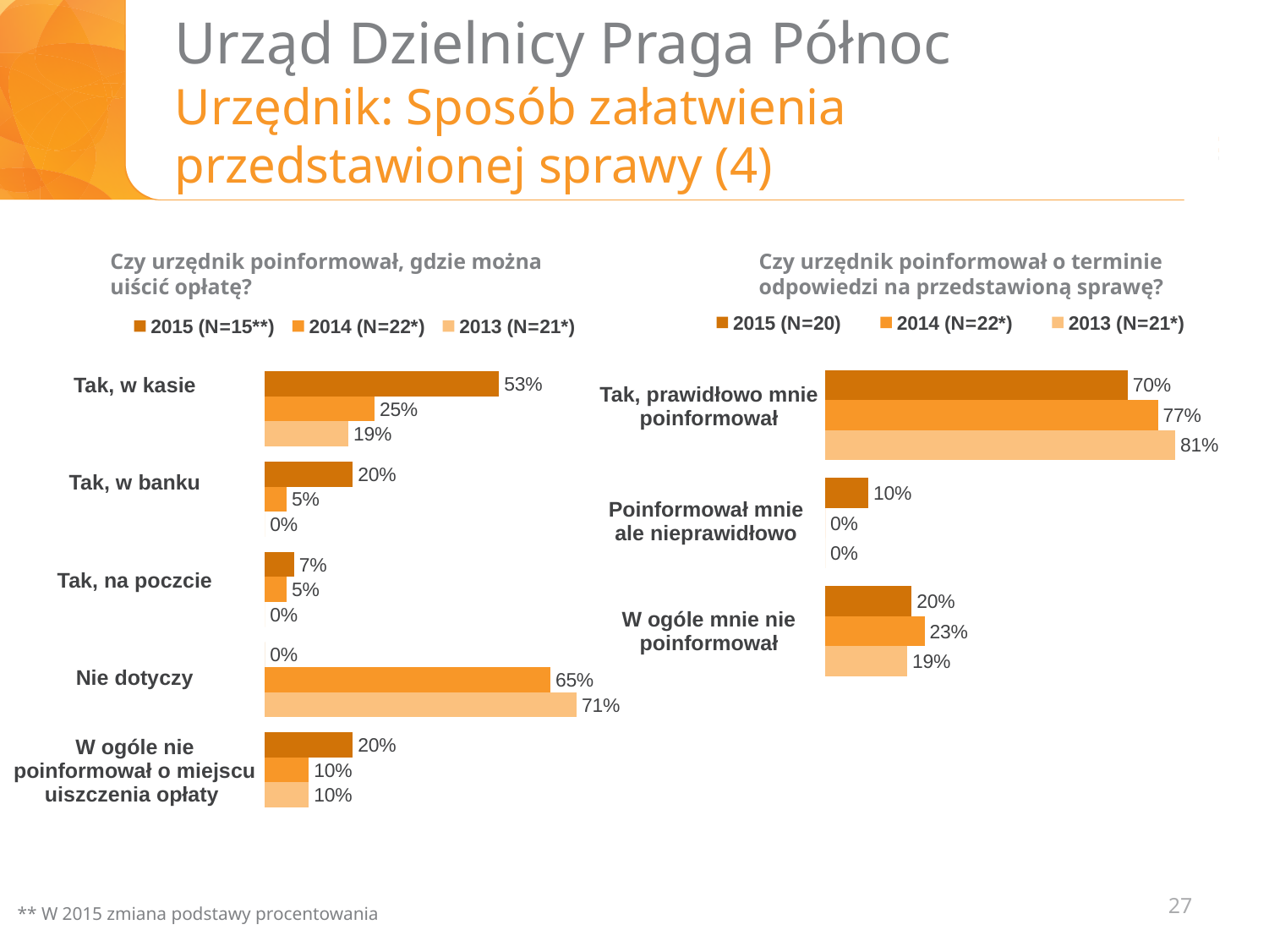
In the right chart ('Czy urzędnik poinformował o terminie odpowiedzi na przedstawioną sprawę?'), what is the value for 'Tak, prawidłowo mnie poinformował' in 2014 (N=22*)? 77% In the left chart ('Czy urzędnik poinformował, gdzie można uiścić opłatę?'), what is the value for 'Tak, w kasie' in 2015 (N=15**)? 53% What type of chart is the right chart ('Czy urzędnik poinformował o terminie odpowiedzi na przedstawioną sprawę?')? Bar chart In the right chart ('Czy urzędnik poinformował o terminie odpowiedzi na przedstawioną sprawę?'), what is the difference between the 2013 (N=21*) and 2015 (N=20) values for 'Tak, prawidłowo mnie poinformował'? 11 percentage points In the right chart ('Czy urzędnik poinformował o terminie odpowiedzi na przedstawioną sprawę?'), which category has the highest value for 2013 (N=21*)? Tak, prawidłowo mnie poinformował In the left chart ('Czy urzędnik poinformował, gdzie można uiścić opłatę?'), which is larger for 'Tak, w kasie': the 2014 (N=22*) value or the 2013 (N=21*) value? 2014 (N=22*) How many series does the legend of the right chart ('Czy urzędnik poinformował o terminie odpowiedzi na przedstawioną sprawę?') list? 3 What is the first legend entry of the left chart ('Czy urzędnik poinformował, gdzie można uiścić opłatę?')? 2015 (N=15**) How many categories are shown in the left chart ('Czy urzędnik poinformował, gdzie można uiścić opłatę?')? 5 In the left chart ('Czy urzędnik poinformował, gdzie można uiścić opłatę?'), which category has the lowest value for 2015 (N=15**)? Nie dotyczy In the left chart ('Czy urzędnik poinformował, gdzie można uiścić opłatę?'), what is the value for 'Nie dotyczy' in 2013 (N=21*)? 71% In the right chart ('Czy urzędnik poinformował o terminie odpowiedzi na przedstawioną sprawę?'), what is the value for 'Poinformował mnie ale nieprawidłowo' in 2015 (N=20)? 10%